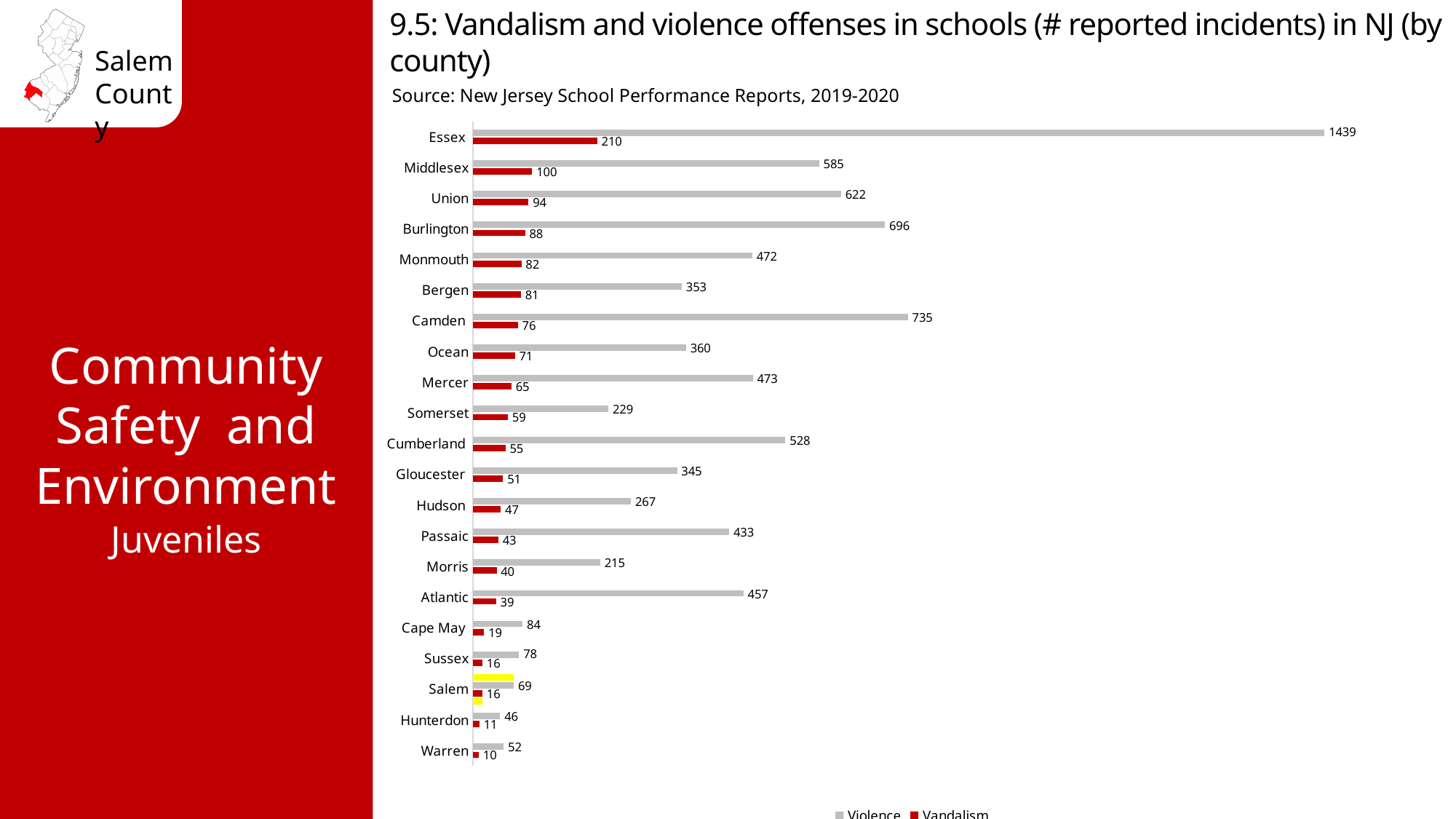
Which county has the lowest number of reported vandalism incidents? Warren How many series does the legend list? 2 Which county has the highest number of reported violence incidents? Essex What type of chart is shown on the slide? bar chart What is the number of reported violence incidents for Camden? 735 Which colour represents the Vandalism series? red What is the number of reported violence incidents for Essex? 1439 Do the vandalism values rise or fall going down the list from Essex to Warren? fall What is the number of reported vandalism incidents for Salem? 16 Which county has more reported violence incidents, Burlington or Union? Burlington What is the difference between the violence incidents for Essex and Middlesex? 854 How many counties are listed on the chart? 21